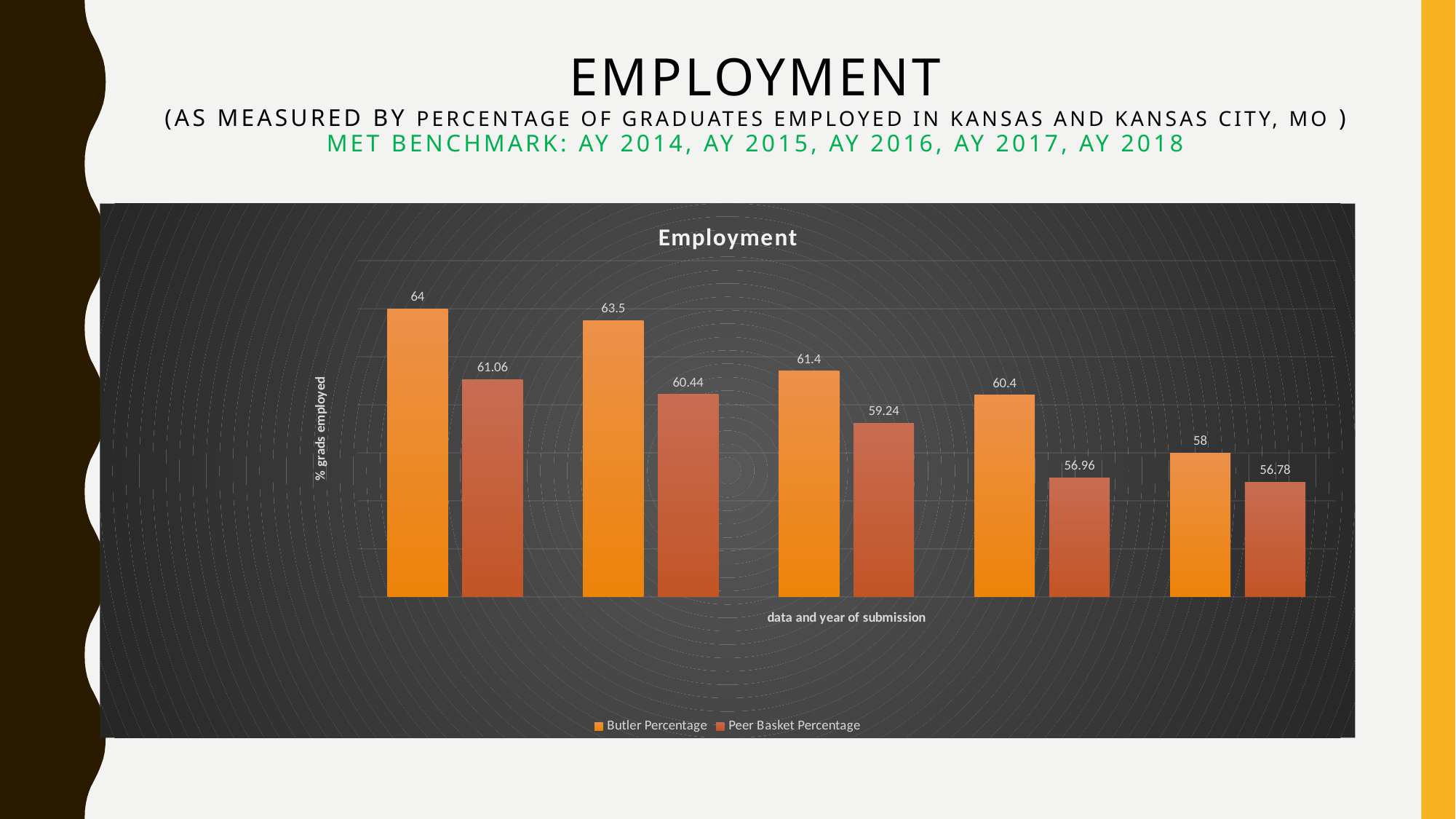
In the third group of bars, which is larger: the Butler Percentage or the Peer Basket Percentage? Butler Percentage What kind of chart is shown on the slide? bar chart What is the Butler Percentage value for the first (leftmost) group of bars? 64 What is the title of the chart? Employment What is the lowest Peer Basket Percentage value shown in the chart? 56.78 In the first (leftmost) group, what is the difference between the Butler Percentage and the Peer Basket Percentage? 2.94 What is the Peer Basket Percentage value for the last (rightmost) group of bars? 56.78 How many groups of bars are plotted in the chart? 5 How many series does the legend list? 2 What is the label on the vertical axis of the chart? % grads employed Do the Butler Percentage values rise or fall from left to right across the chart? fall What is the highest Butler Percentage value shown in the chart? 64